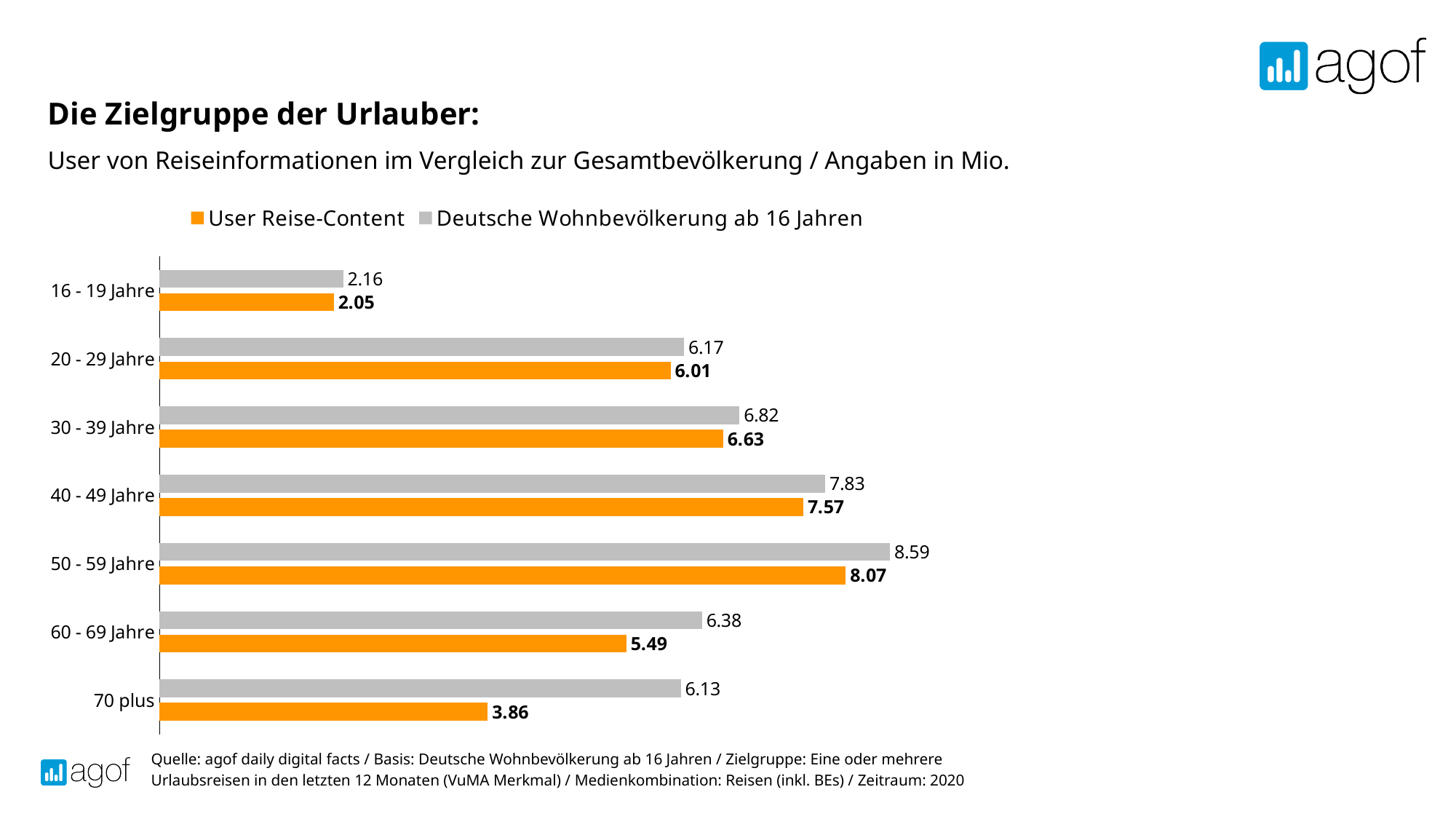
How many series does the legend list? 2 What is the value for User Reise-Content in the 50 - 59 Jahre age group? 8.07 How many age groups are shown on the chart? 7 What is the value for Deutsche Wohnbevölkerung ab 16 Jahren in the 70 plus age group? 6.13 Which age group has the lowest value for User Reise-Content? 16 - 19 Jahre What kind of chart is shown on the slide? Bar chart What is the difference between Deutsche Wohnbevölkerung ab 16 Jahren and User Reise-Content in the 70 plus age group? 2.27 What is the difference between Deutsche Wohnbevölkerung ab 16 Jahren and User Reise-Content in the 60 - 69 Jahre age group? 0.89 Which is larger: User Reise-Content for 40 - 49 Jahre or User Reise-Content for 30 - 39 Jahre? 40 - 49 Jahre Which colour represents User Reise-Content in the chart? Orange Which age group has the highest value for Deutsche Wohnbevölkerung ab 16 Jahren? 50 - 59 Jahre What is the value for User Reise-Content in the 16 - 19 Jahre age group? 2.05